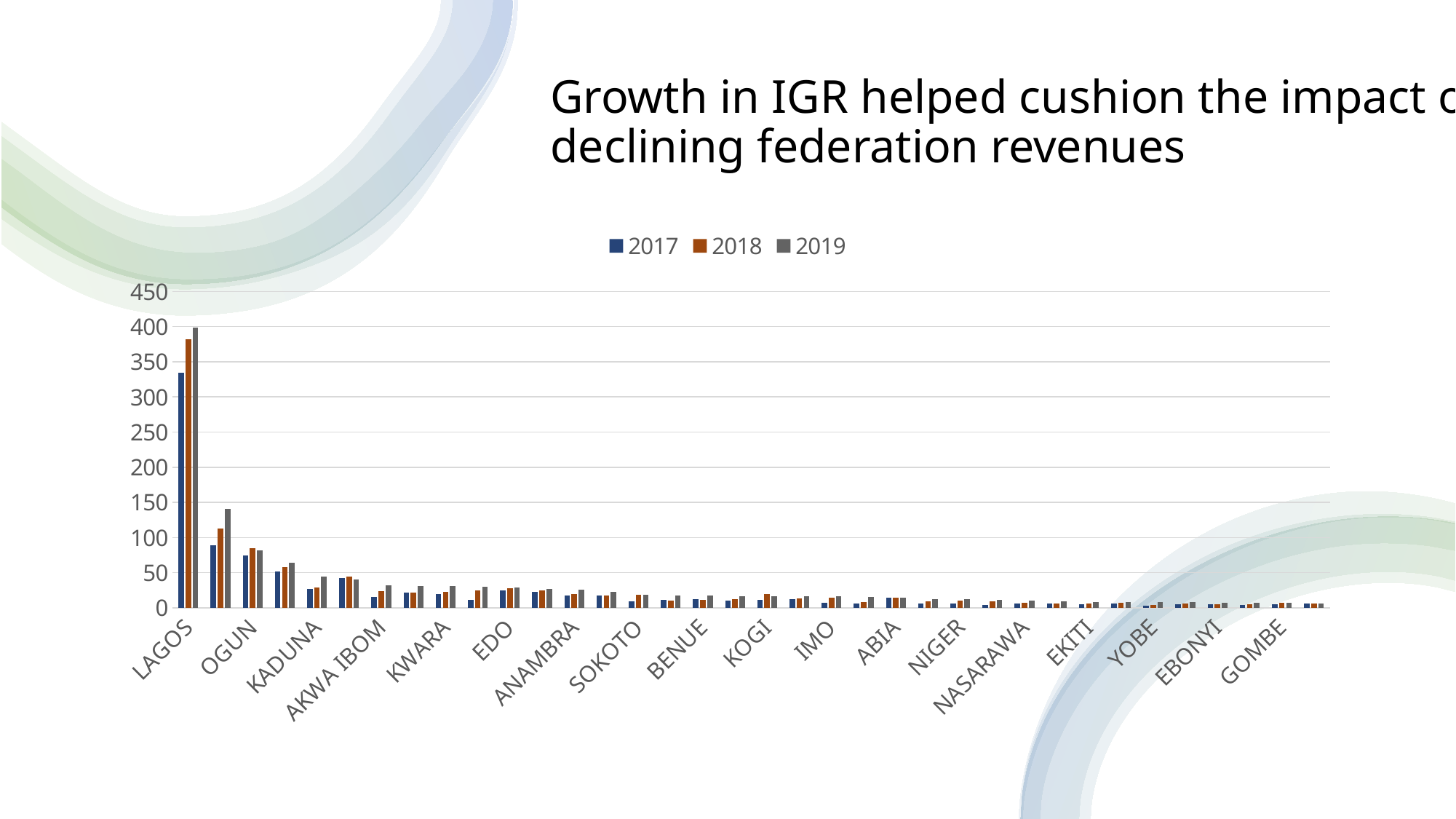
Which series is shown in grey in the legend? 2019 Is the 2017 value for LAGOS greater or less than 300? greater For LAGOS, which year has the lowest value? 2017 Is the 2019 value for OGUN greater or less than 150? less Is the 2019 value for OGUN greater or less than 100? less Do the values generally rise or fall moving from left to right along the x axis? fall For OGUN, which is larger: the 2017 value or the 2019 value? 2019 Which category has the highest values in the chart? LAGOS How many series does the legend list? 3 What kind of chart is shown on the slide? bar chart